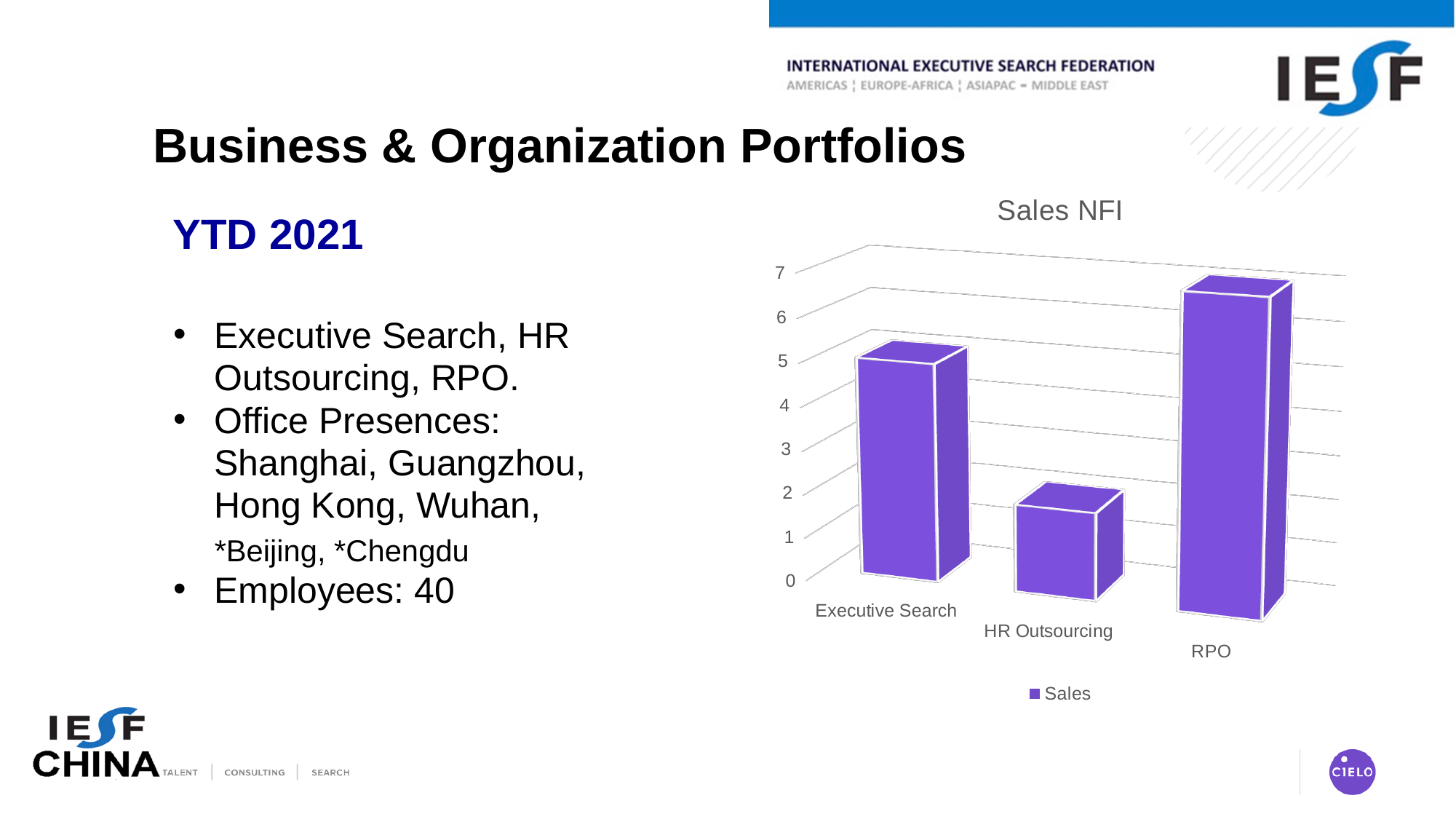
Which has a larger Sales value, RPO or Executive Search? RPO Which category has the highest Sales value in the chart? RPO Is the Sales value for RPO greater or less than 5? greater How many series does the chart legend list? 1 How many categories are shown on the x axis of the chart? 3 Is the Sales value for Executive Search greater or less than 4? greater What is the title of the chart? Sales NFI What is the name of the series shown in the chart legend? Sales Which category has the lowest Sales value in the chart? HR Outsourcing Which has a larger Sales value, Executive Search or HR Outsourcing? Executive Search Is the Sales value for HR Outsourcing greater or less than 3? less What type of chart is shown on the slide? bar chart